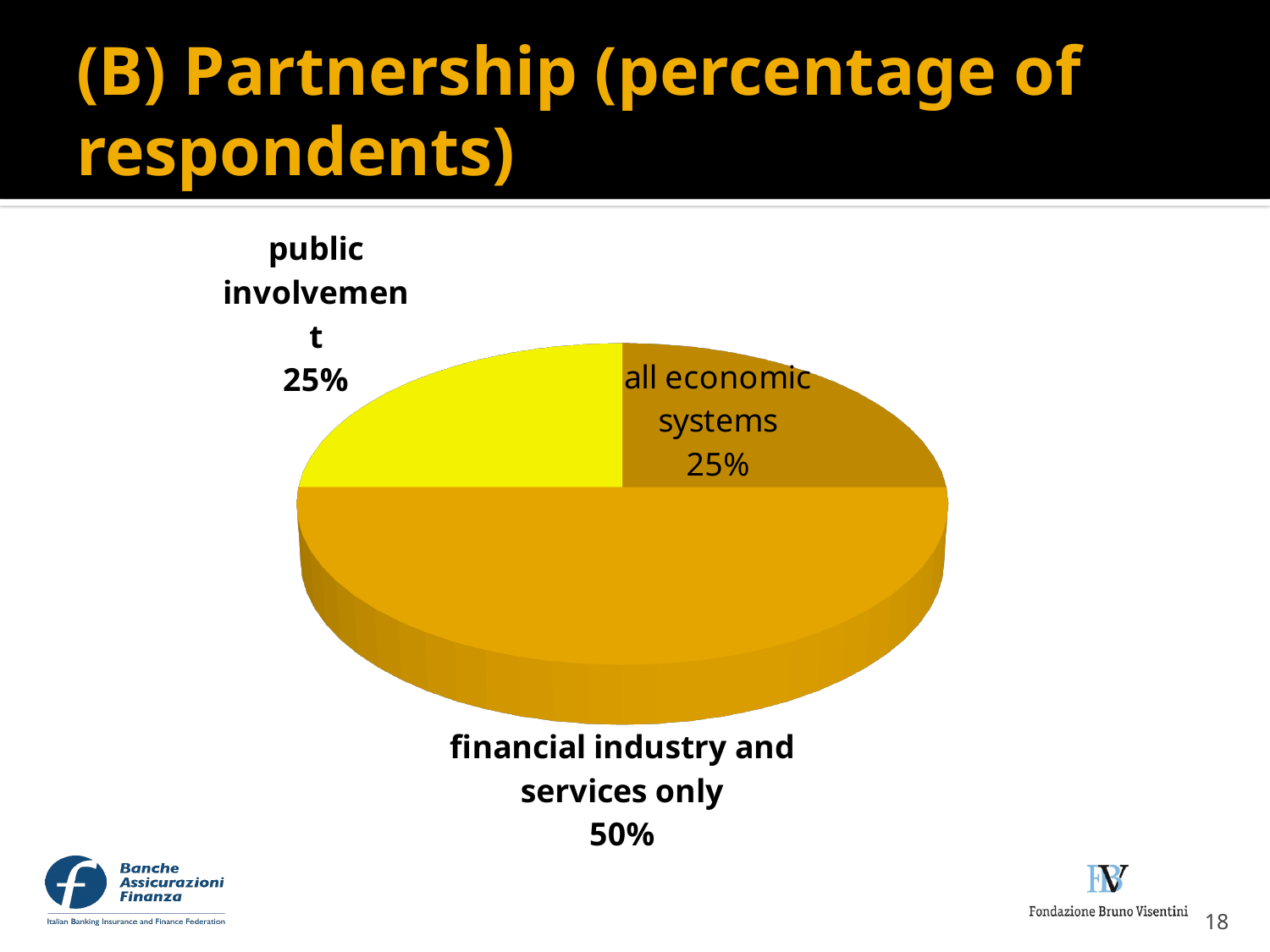
What kind of chart is shown on the slide? pie chart What is the difference between the share for 'financial industry and services only' and the share for 'public involvement'? 25% What percentage of respondents chose 'public involvement'? 25% Which is larger: the share for 'financial industry and services only' or the share for 'all economic systems'? financial industry and services only What is the title of the chart on the slide? (B) Partnership (percentage of respondents) What percentage of respondents chose 'financial industry and services only'? 50% Which category has the largest share of the pie? financial industry and services only What percentage of respondents chose 'all economic systems'? 25% What is the combined share of 'public involvement' and 'all economic systems'? 50% Which slice of the pie is coloured bright yellow? public involvement How many slices does the pie chart have? 3